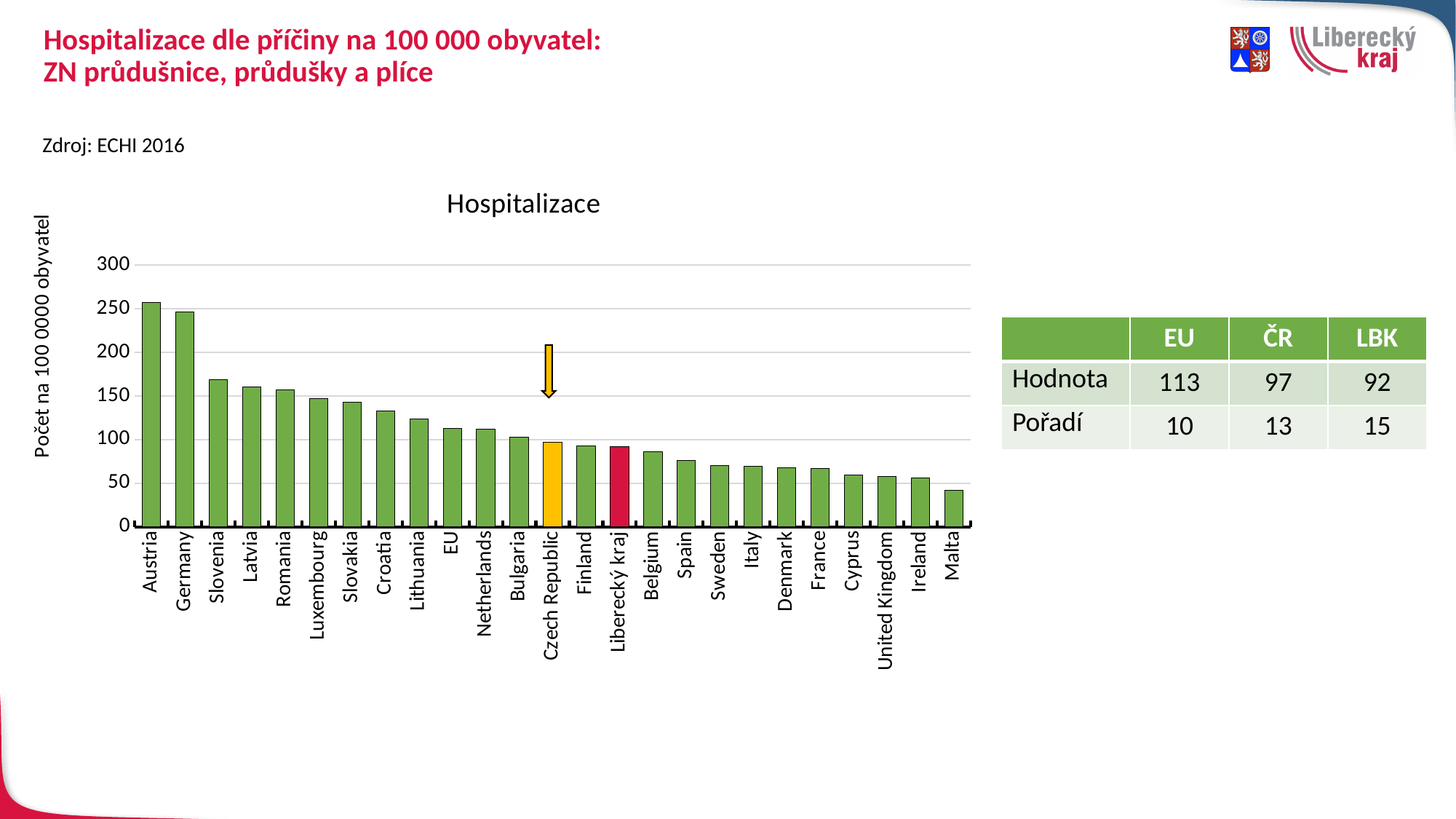
How many categories (bars) are shown in the chart? 25 What is the difference between the EU value and the Czech Republic value? 16 Which country has the highest hospitalization rate in the chart? Austria What type of chart is shown on the slide? bar chart What is the hospitalization value for Liberecký kraj (LBK)? 92 Is the value for Spain greater or less than 100? less What is the difference between the Czech Republic value and the Liberecký kraj value? 5 Do the values rise or fall from left to right along the x axis? fall What is the hospitalization value for the EU? 113 What is the hospitalization value for the Czech Republic (ČR)? 97 Which country has the lowest hospitalization rate in the chart? Malta Is the value for Slovenia greater or less than 150? greater